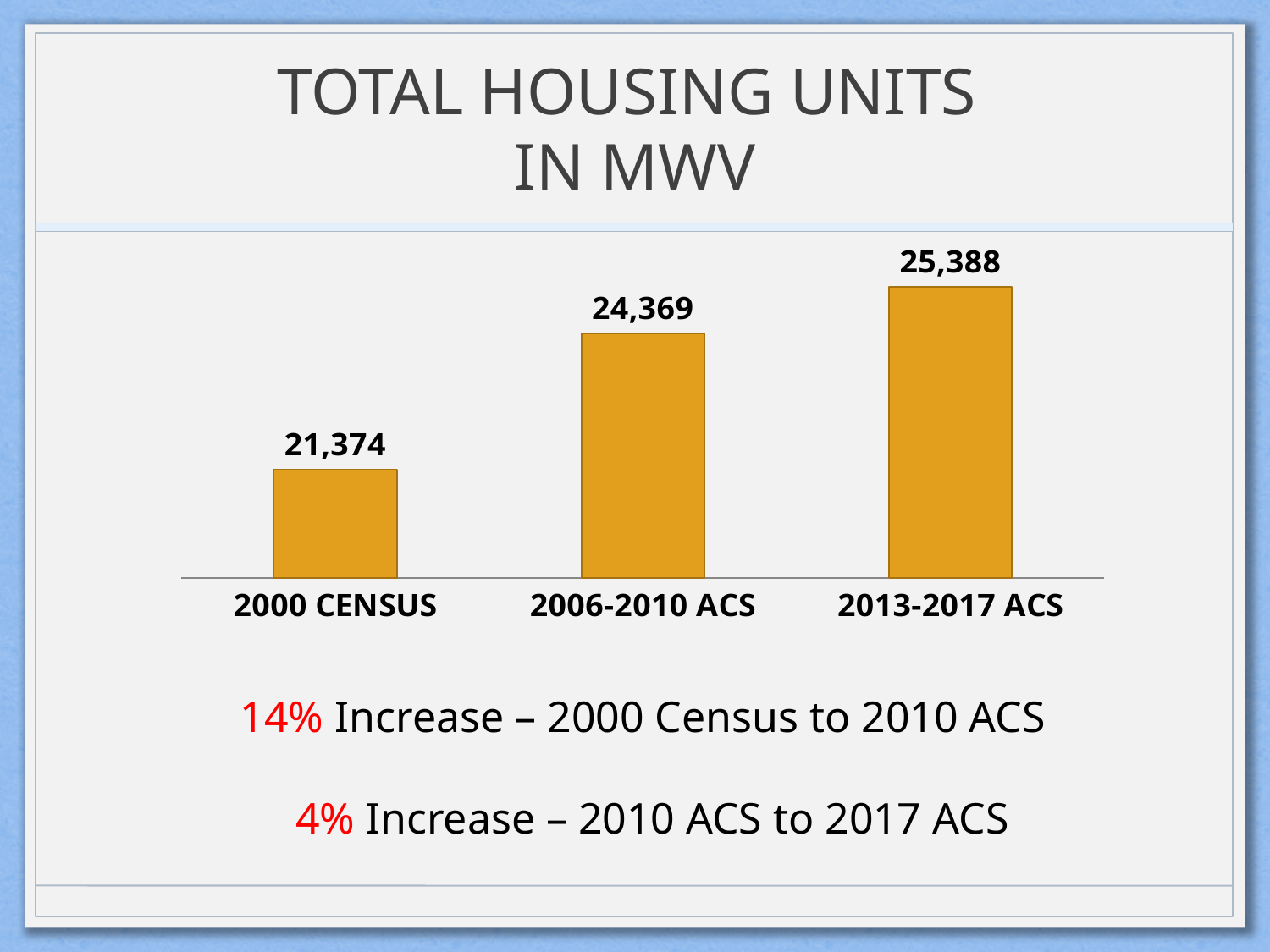
Which period has the highest number of total housing units? 2013-2017 ACS What is the total housing units value for the 2013-2017 ACS? 25,388 Do the values rise or fall from left to right across the chart? Rise What kind of chart is shown on the slide? Bar chart Which is larger, the housing units for the 2000 Census or for the 2006-2010 ACS? 2006-2010 ACS What is the total housing units value for the 2006-2010 ACS? 24,369 What is the title of the chart on the slide? Total Housing Units in MWV How many categories are shown in the chart? 3 What is the total housing units value for the 2000 Census? 21,374 What is the difference in housing units between the 2013-2017 ACS and the 2006-2010 ACS? 1,019 Which period has the lowest number of total housing units? 2000 Census What is the difference in housing units between the 2006-2010 ACS and the 2000 Census? 2,995